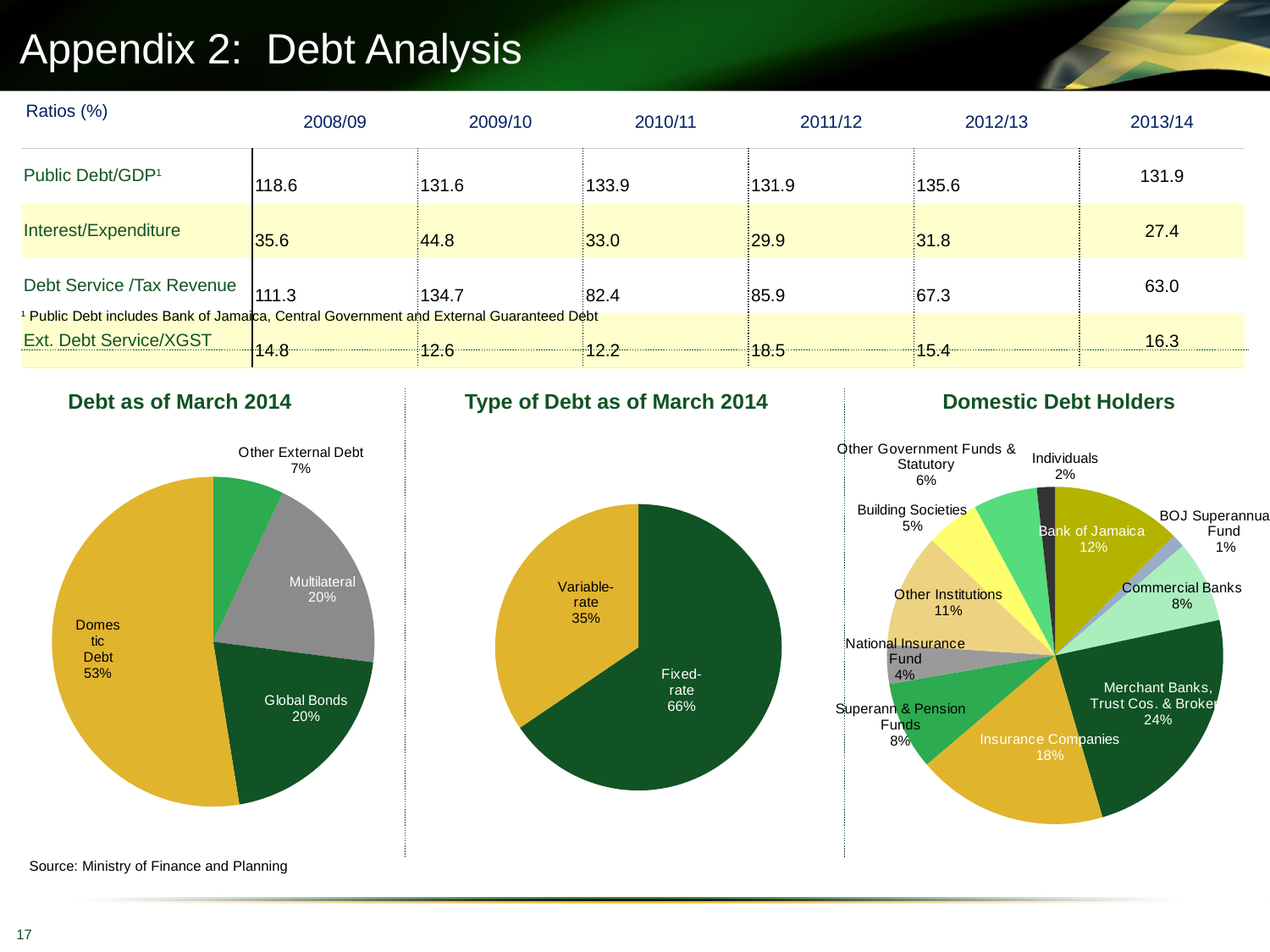
In the 'Type of Debt as of March 2014' chart, what is the difference between the Fixed-rate and Variable-rate shares? 31 percentage points In the 'Domestic Debt Holders' chart, which holder has the smallest share? BOJ Superannuation Fund In the 'Domestic Debt Holders' chart, what share is held by Insurance Companies? 18% In the 'Debt as of March 2014' chart, what share is Domestic Debt? 53% In the 'Domestic Debt Holders' chart, how many holder categories are shown? 11 In the 'Debt as of March 2014' chart, which category has the largest share? Domestic Debt In the 'Type of Debt as of March 2014' chart, what share is Fixed-rate debt? 66% In the 'Domestic Debt Holders' chart, which is larger: Bank of Jamaica or Commercial Banks? Bank of Jamaica In the 'Debt as of March 2014' chart, how many slices does the pie have? 4 In the 'Domestic Debt Holders' chart, which holder has the largest share? Merchant Banks, Trust Cos. & Brokers What kind of chart is the 'Type of Debt as of March 2014' chart? Pie chart